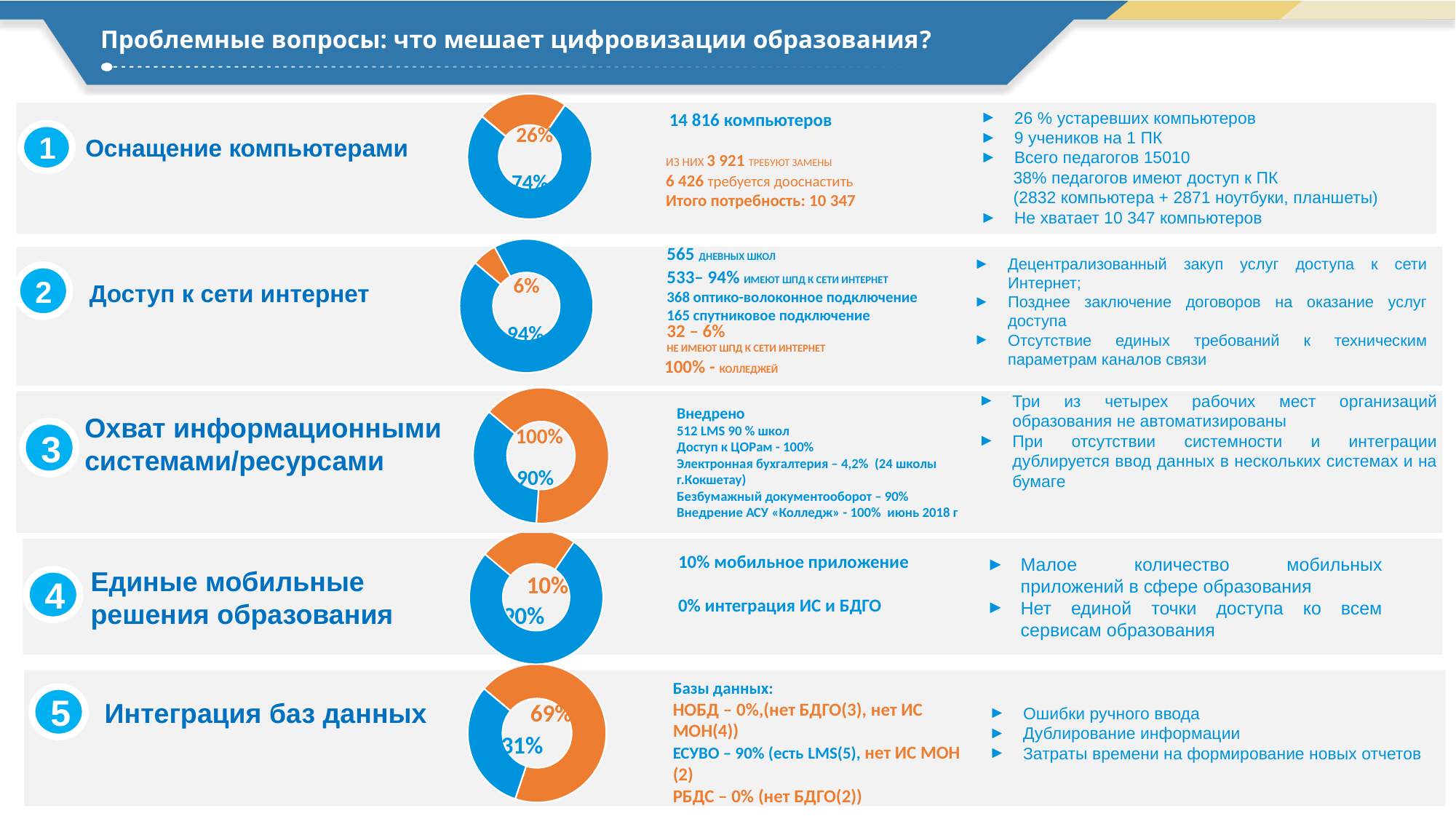
How many donut charts are shown on the slide? 5 In the chart for row 2, 'Доступ к сети интернет', what is the difference between the blue slice value and the orange slice value? 88% In the chart for row 4, 'Единые мобильные решения образования', what value is printed on the orange slice? 10% How many slices does the chart for row 1, 'Оснащение компьютерами', have? 2 In the chart for row 5, 'Интеграция баз данных', what value is printed on the blue slice? 31% In the chart for row 1, 'Оснащение компьютерами', what value is printed on the blue slice? 74% What kind of chart is used in row 1, 'Оснащение компьютерами'? Pie (donut) chart In the chart for row 5, 'Интеграция баз данных', what value is printed on the orange slice? 69% In the chart for row 5, 'Интеграция баз данных', which slice is larger, the orange one or the blue one? Orange In the chart for row 2, 'Доступ к сети интернет', what value is printed on the blue slice? 94% In the chart for row 1, 'Оснащение компьютерами', what value is printed on the orange slice? 26% In the chart for row 2, 'Доступ к сети интернет', what value is printed on the orange slice? 6%